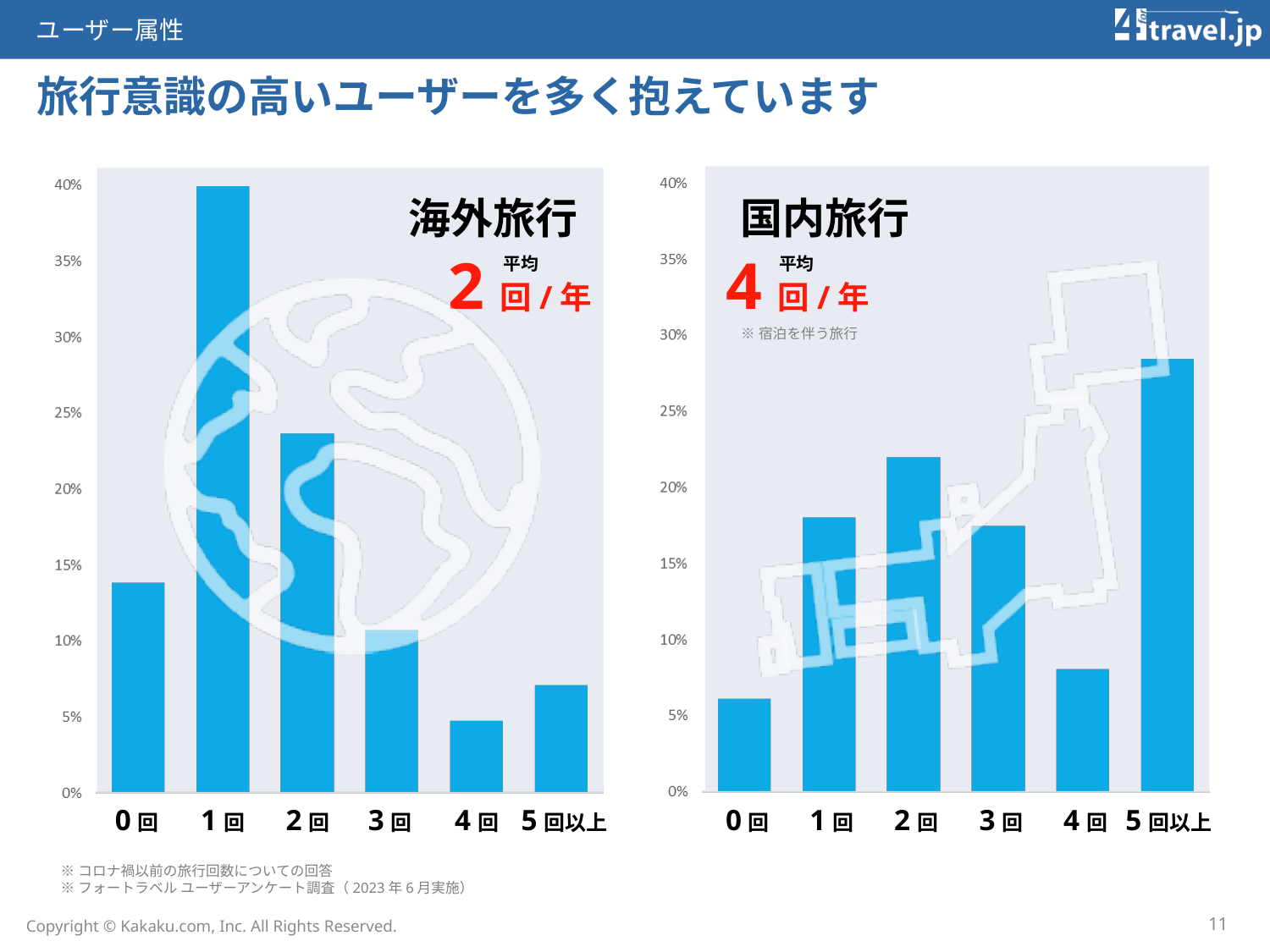
In the 国内旅行 chart, which category has the highest value? 5回以上 In the 海外旅行 chart, which category has the lowest value? 4回 How many categories are shown on the x axis of the 海外旅行 chart? 6 What kind of chart is the 国内旅行 chart? bar chart In the 国内旅行 chart, is the value for 4回 greater or less than 10%? less In the 国内旅行 chart, is the value for 5回以上 greater or less than 25%? greater In the 国内旅行 chart, which category has the lowest value? 0回 In the 海外旅行 chart, which is larger, the value for 2回 or the value for 3回? 2回 What average number of trips per year is printed on the 国内旅行 chart? 4回/年 In the 国内旅行 chart, which is larger, the value for 2回 or the value for 4回? 2回 In the 海外旅行 chart, which category has the highest value? 1回 In the 海外旅行 chart, is the value for 0回 greater or less than 10%? greater